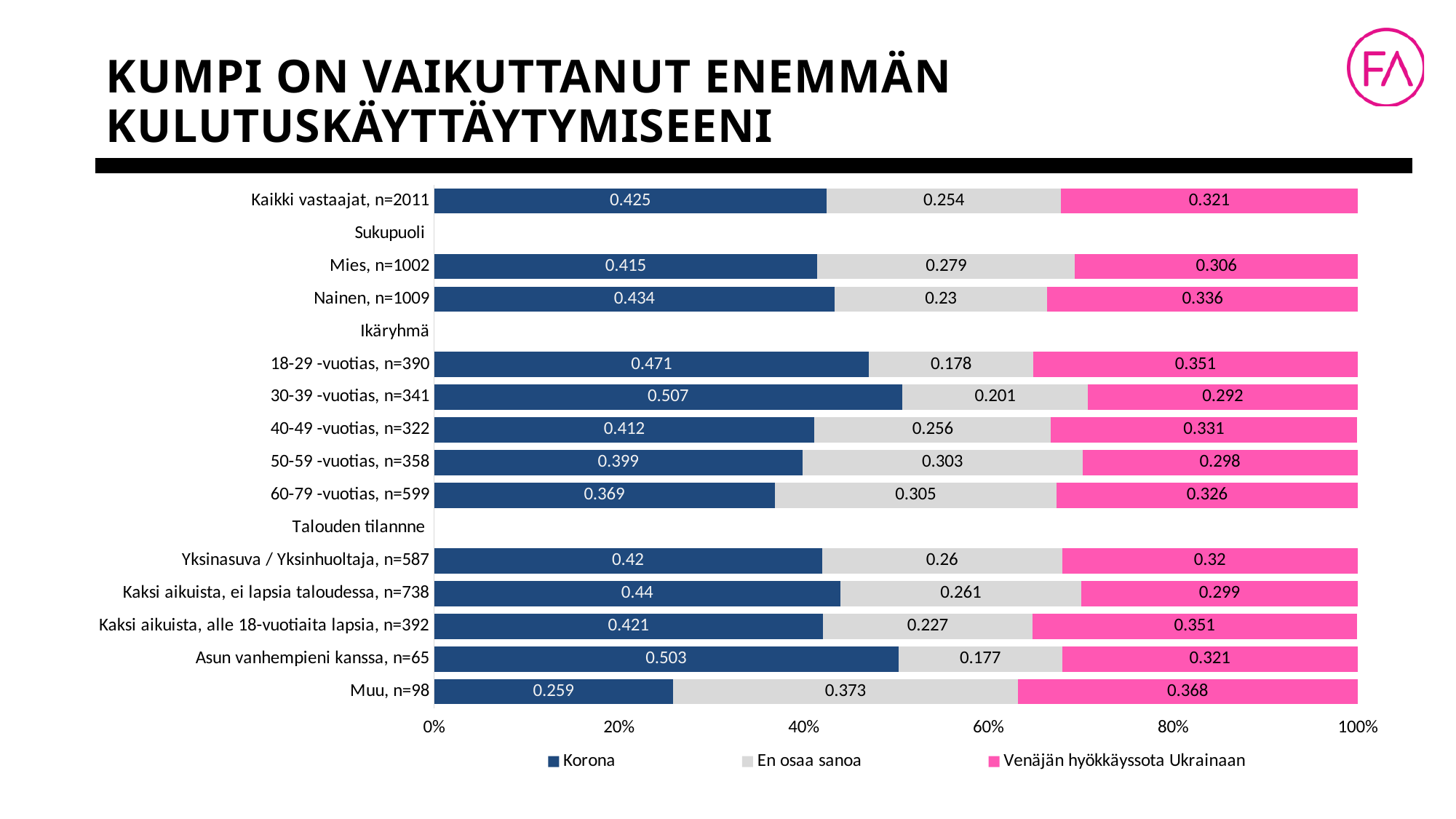
Is the Korona value for Muu, n=98 greater or less than 40%? less Which category has the highest Korona value? 30-39 -vuotias, n=341 What kind of chart is shown on the slide? Stacked bar chart How many bars are plotted in the chart? 13 Which category has the highest En osaa sanoa value? Muu, n=98 How many series does the legend list? 3 Which category has the lowest Korona value? Muu, n=98 What is the Venäjän hyökkäyssota Ukrainaan value for Muu, n=98? 0.368 What is the Korona value for Kaikki vastaajat, n=2011? 0.425 What is the En osaa sanoa value for 50-59 -vuotias, n=358? 0.303 What is the difference between the Korona values for Nainen, n=1009 and Mies, n=1002? 0.019 Which has the larger Korona value: 18-29 -vuotias, n=390 or 60-79 -vuotias, n=599? 18-29 -vuotias, n=390